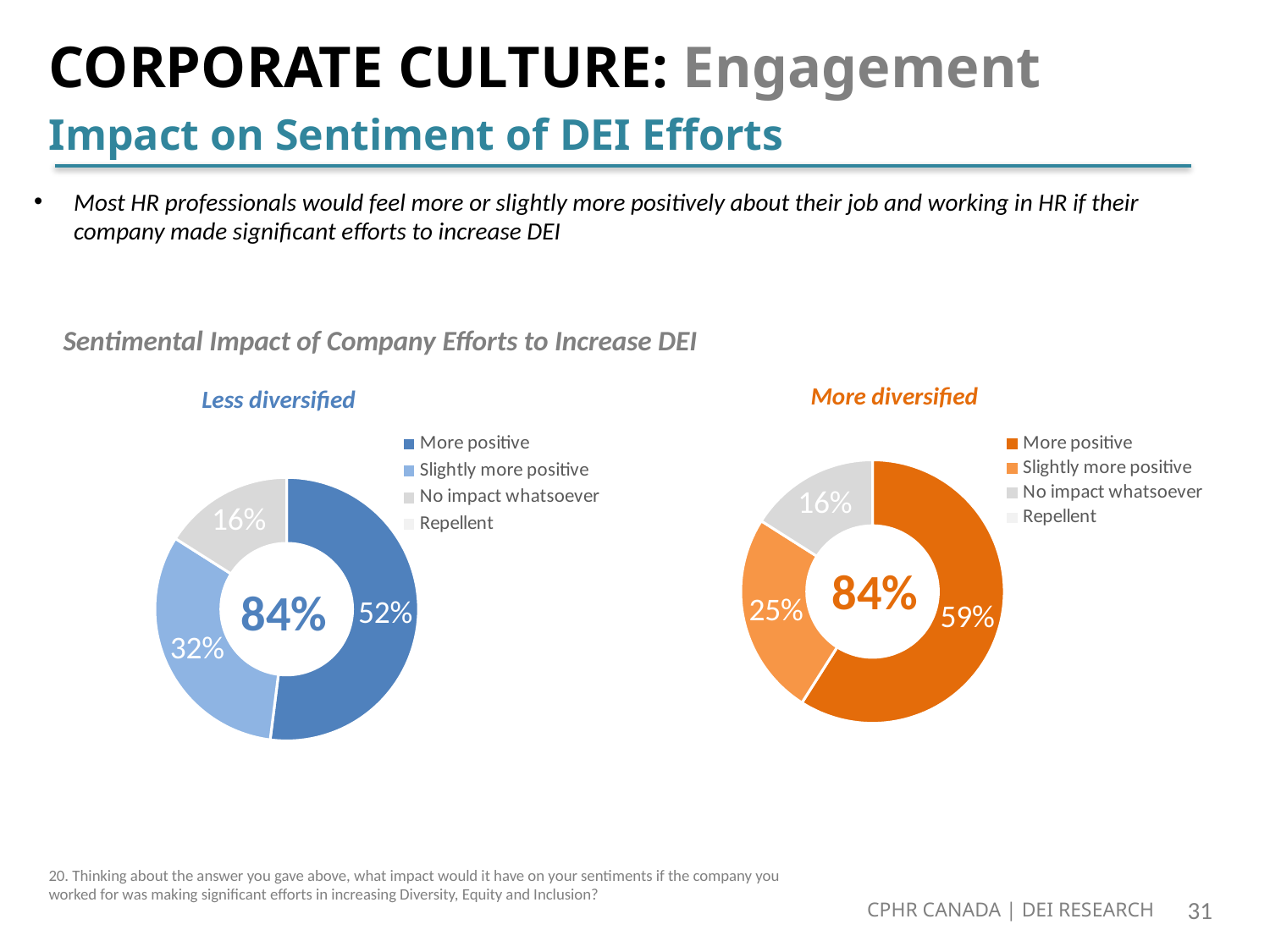
In the More diversified chart, which labelled category has the smallest share? No impact whatsoever In the Less diversified chart, what percentage of respondents said More positive? 52% Which chart has the larger Slightly more positive share, Less diversified or More diversified? Less diversified What is the difference between the More positive share in the More diversified chart and the More positive share in the Less diversified chart? 7% In the Less diversified chart, which category has the largest share? More positive In the More diversified chart, what percentage of respondents said Slightly more positive? 25% In the Less diversified chart, what percentage of respondents said Slightly more positive? 32% What type of chart is used for the Less diversified data? Donut chart How many categories does the legend of the More diversified chart list? 4 What combined percentage is shown in the centre of the Less diversified chart? 84% In the More diversified chart, what percentage of respondents said More positive? 59% In the More diversified chart, what percentage of respondents said No impact whatsoever? 16%